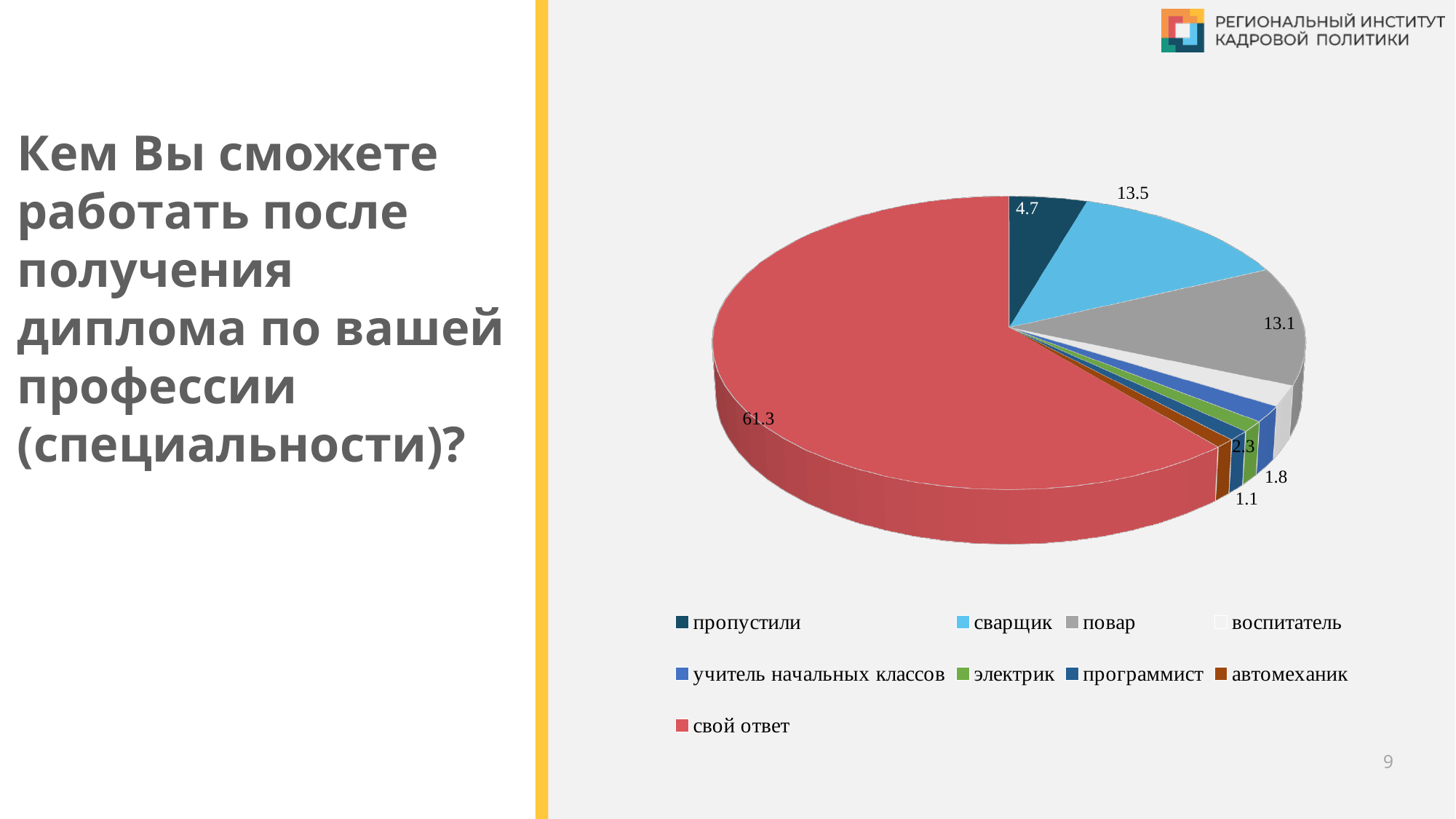
What is the difference between the values for "свой ответ" and "сварщик"? 47.8 What is the value for the "сварщик" slice? 13.5 What is the value for the "пропустили" slice? 4.7 What is the value for the "свой ответ" slice? 61.3 What type of chart is shown on the slide? pie chart What is the difference between the values for "сварщик" and "пропустили"? 8.8 What is the difference between the values for "сварщик" and "повар"? 0.4 What colour is the "свой ответ" slice in the pie chart? red What is the value for the "повар" slice? 13.1 Which is larger, the value for "сварщик" or the value for "повар"? сварщик How many categories does the legend of the pie chart list? 9 Which category has the largest slice of the pie? свой ответ